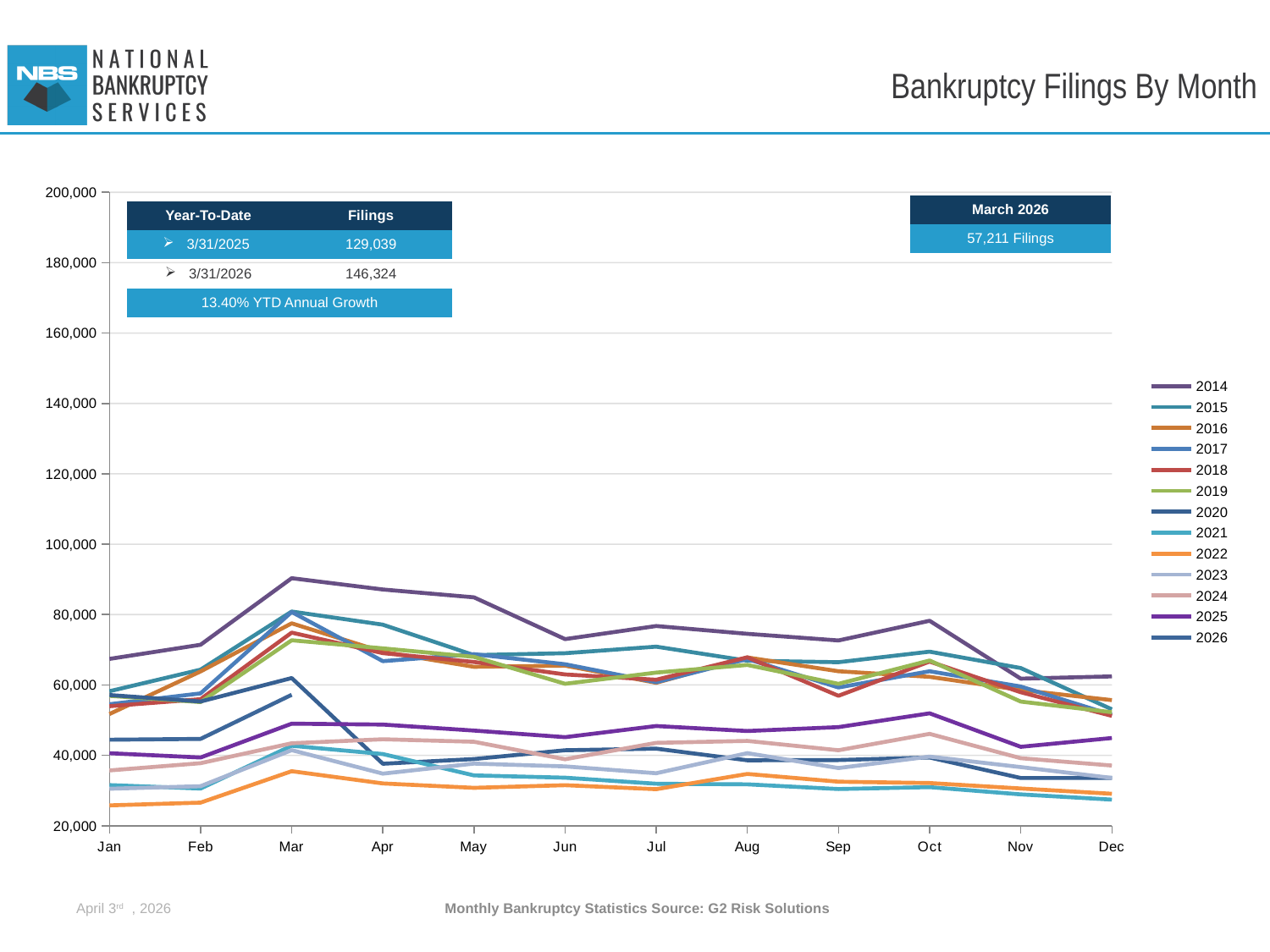
Which year has the lowest value in Jan? 2022 How many series does the legend list? 13 Which is larger in Jul, the value for 2014 or the value for 2022? 2014 What is the difference between the year-to-date filings for 3/31/2026 and 3/31/2025? 17,285 Which year has the highest value in Mar? 2014 What is the year-to-date filings figure for 3/31/2026? 146,324 How many filings does the slide report for March 2026? 57,211 Filings Is the value for 2022 in Jan greater or less than 40,000? less What kind of chart is shown on the slide? line chart How many months are shown along the x axis? 12 Is the value for 2014 in Mar greater or less than 80,000? greater Does the 2026 line rise or fall from Jan to Mar? rise